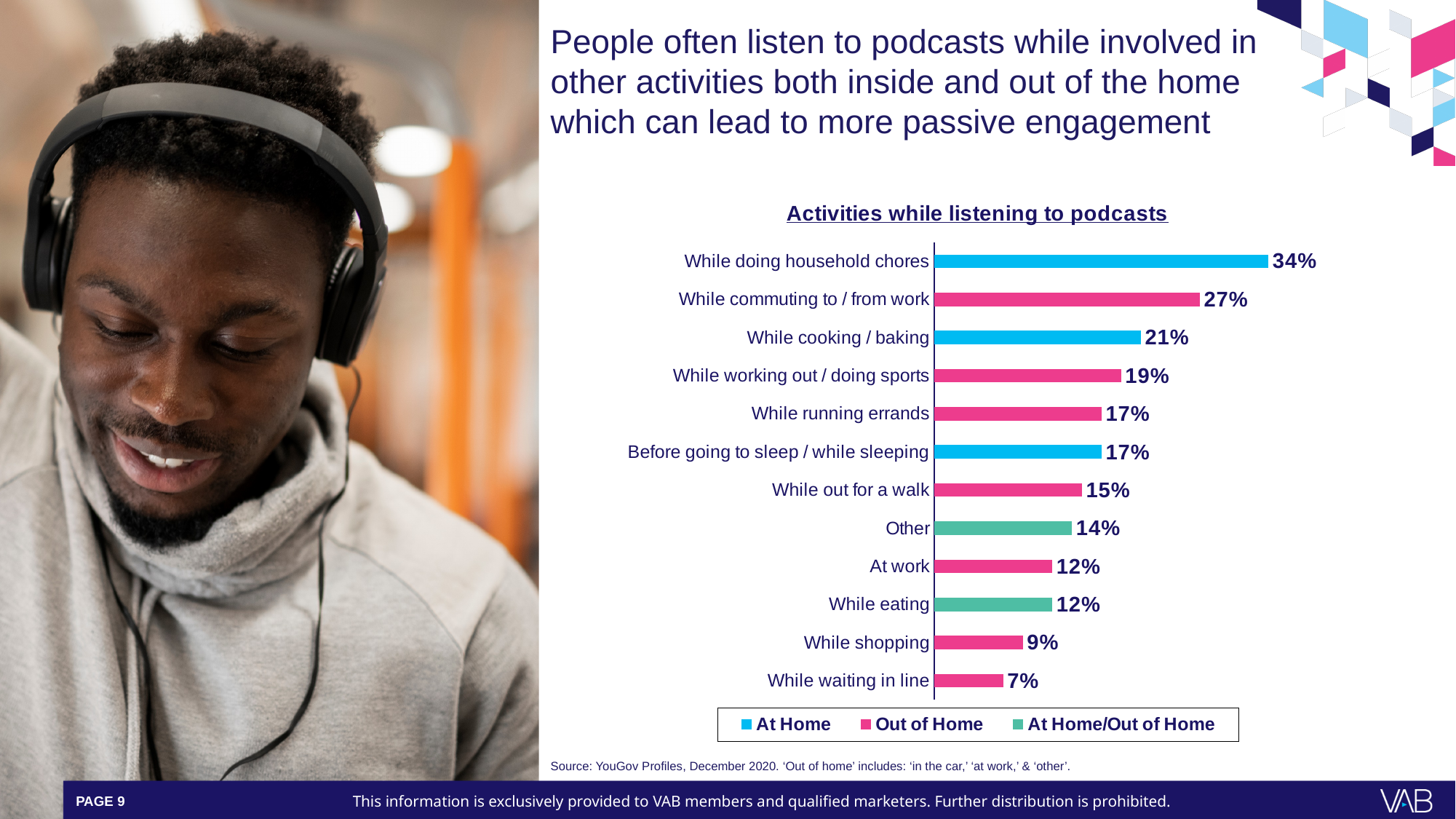
What is the difference between 'While doing household chores' and 'While commuting to / from work'? 7% Which activity has the lowest percentage in the chart? While waiting in line What percentage listen to podcasts while waiting in line? 7% Which activity has the highest percentage in the chart? While doing household chores What kind of chart is shown on the slide? Bar chart How many series does the legend list? 3 What is the value for 'While commuting to / from work'? 27% Which legend series is shown in pink? Out of Home Which is larger: 'While cooking / baking' or 'While working out / doing sports'? While cooking / baking What percentage of people listen to podcasts while doing household chores? 34% How many activities are shown in the chart? 12 What is the title of the chart? Activities while listening to podcasts